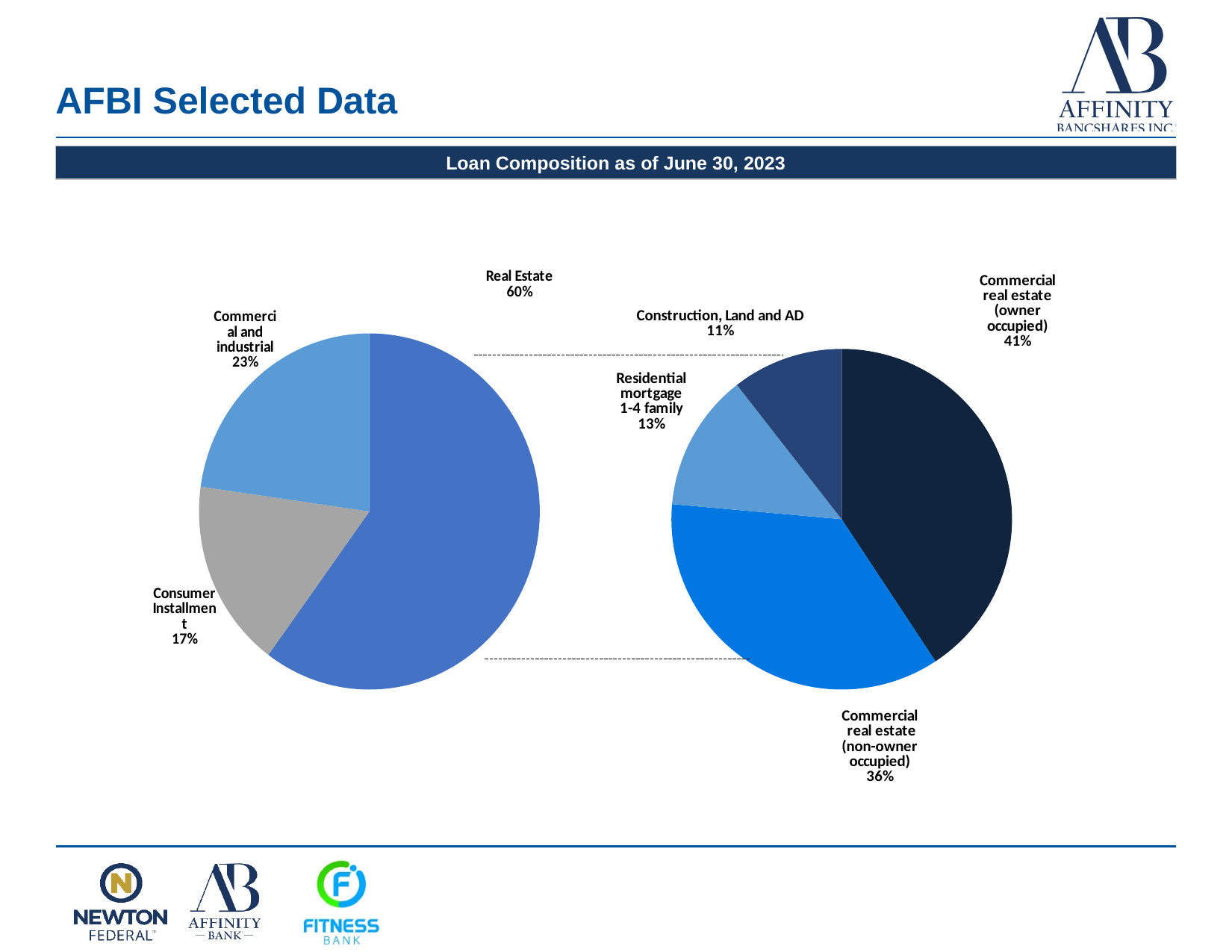
In the right pie, what share is Commercial real estate (non-owner occupied)? 36% In the right pie, which category has the smallest share? Construction, Land and AD In the left pie, what share of loans is Consumer Installment? 17% What type of chart is shown on the slide? Pie chart In the right pie, what share is Commercial real estate (owner occupied)? 41% In the right pie, what share is Residential mortgage 1-4 family? 13% In the left pie, what share of loans is Real Estate? 60% In the right pie, what share is Construction, Land and AD? 11% In the left pie, which category has the largest share? Real Estate In the left pie, what share of loans is Commercial and industrial? 23% How many slices does the right pie have? 4 What is the difference in percentage points between Commercial and industrial and Consumer Installment in the left pie? 6 percentage points